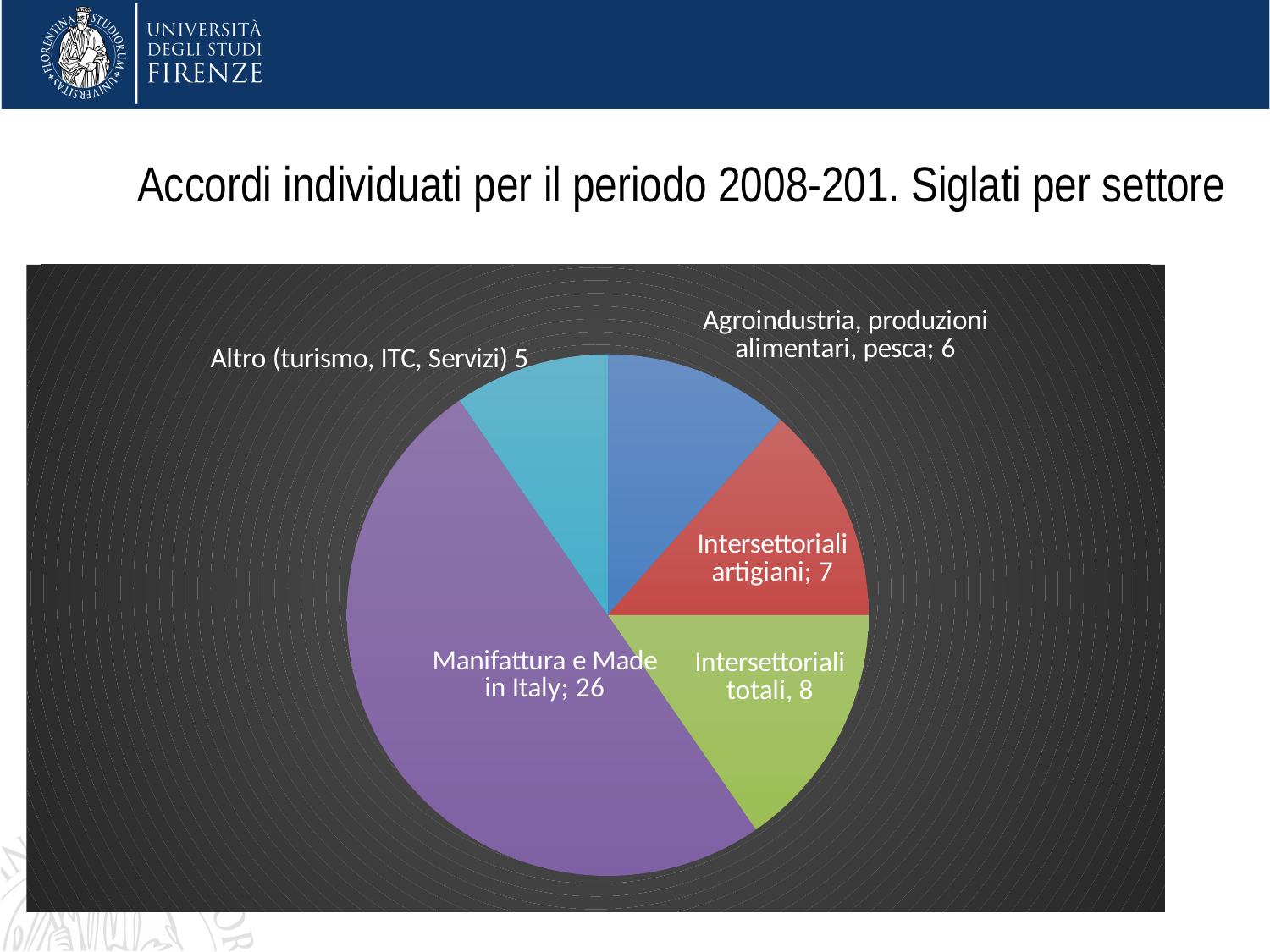
What is the title of the slide containing the pie chart? Accordi individuati per il periodo 2008-201. Siglati per settore What kind of chart is shown on the slide? pie chart How many slices does the pie chart have? 5 Which sector has the largest slice of the pie? Manifattura e Made in Italy What is the value for Intersettoriali artigiani? 7 Which sector has the smallest slice of the pie? Altro (turismo, ITC, Servizi) What share of the pie does Manifattura e Made in Italy represent? 50% What is the value for Agroindustria, produzioni alimentari, pesca? 6 Which is larger, the value for Intersettoriali totali or the value for Intersettoriali artigiani? Intersettoriali totali What is the value for Manifattura e Made in Italy? 26 What is the value for Altro (turismo, ITC, Servizi)? 5 What is the difference between the values for Manifattura e Made in Italy and Intersettoriali totali? 18